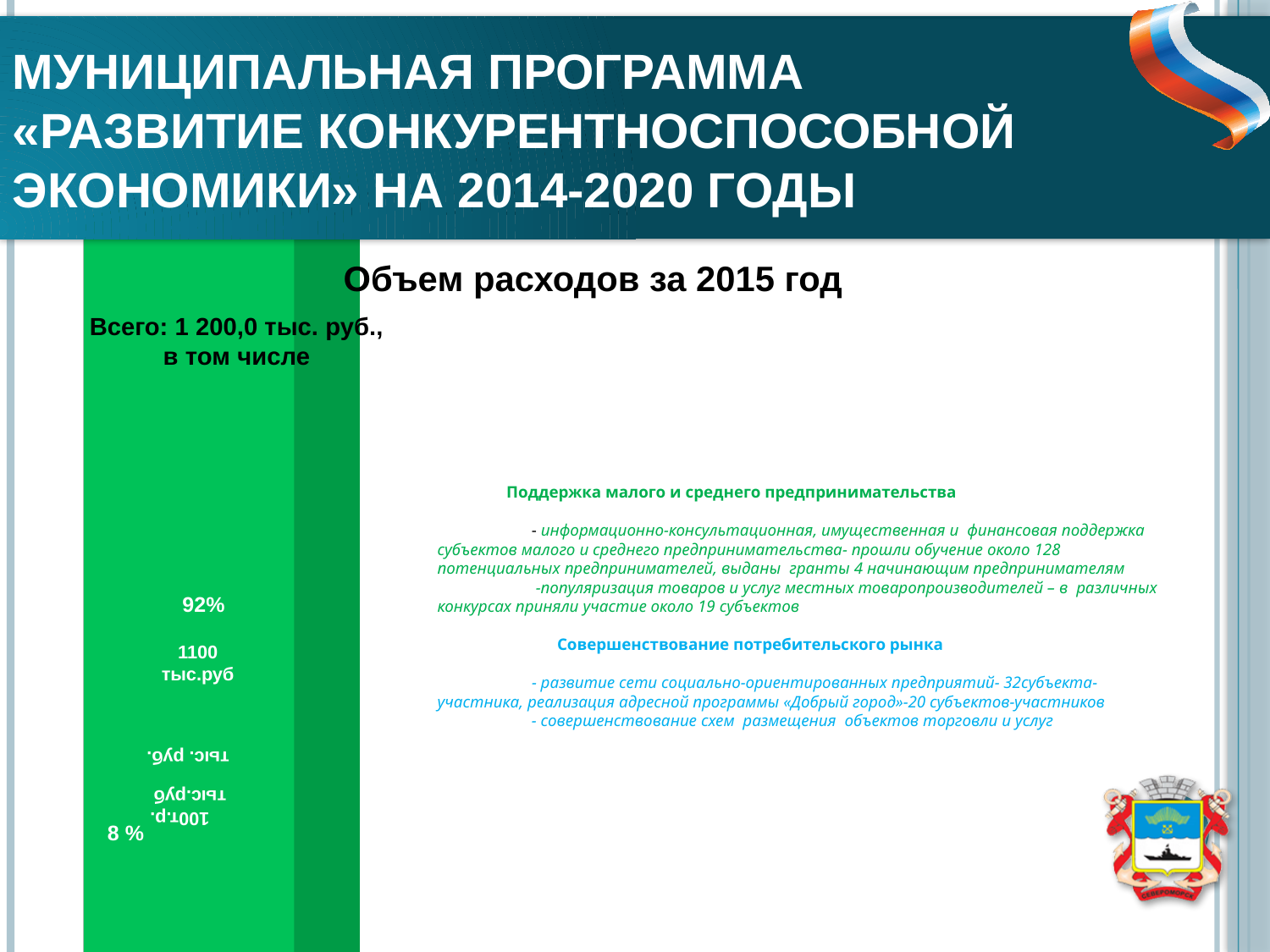
What kind of chart is shown on the slide? bar chart What percentage share is labelled on the larger segment of the bar? 92% What is the total expenditure shown for 2015 according to the chart heading? 1 200,0 тыс. руб. What is the title of the chart on the slide? Объем расходов за 2015 год How many segments does the stacked bar contain? 2 What percentage share is labelled on the smaller segment of the bar? 8 % What colour is the bar on the chart? green What value in thousand rubles is labelled on the larger segment of the bar? 1100 тыс.руб Is the value of the larger segment greater or less than 1000 тыс.руб? greater Which segment of the bar is larger, the one labelled 92% or the one labelled 8 %? 92%